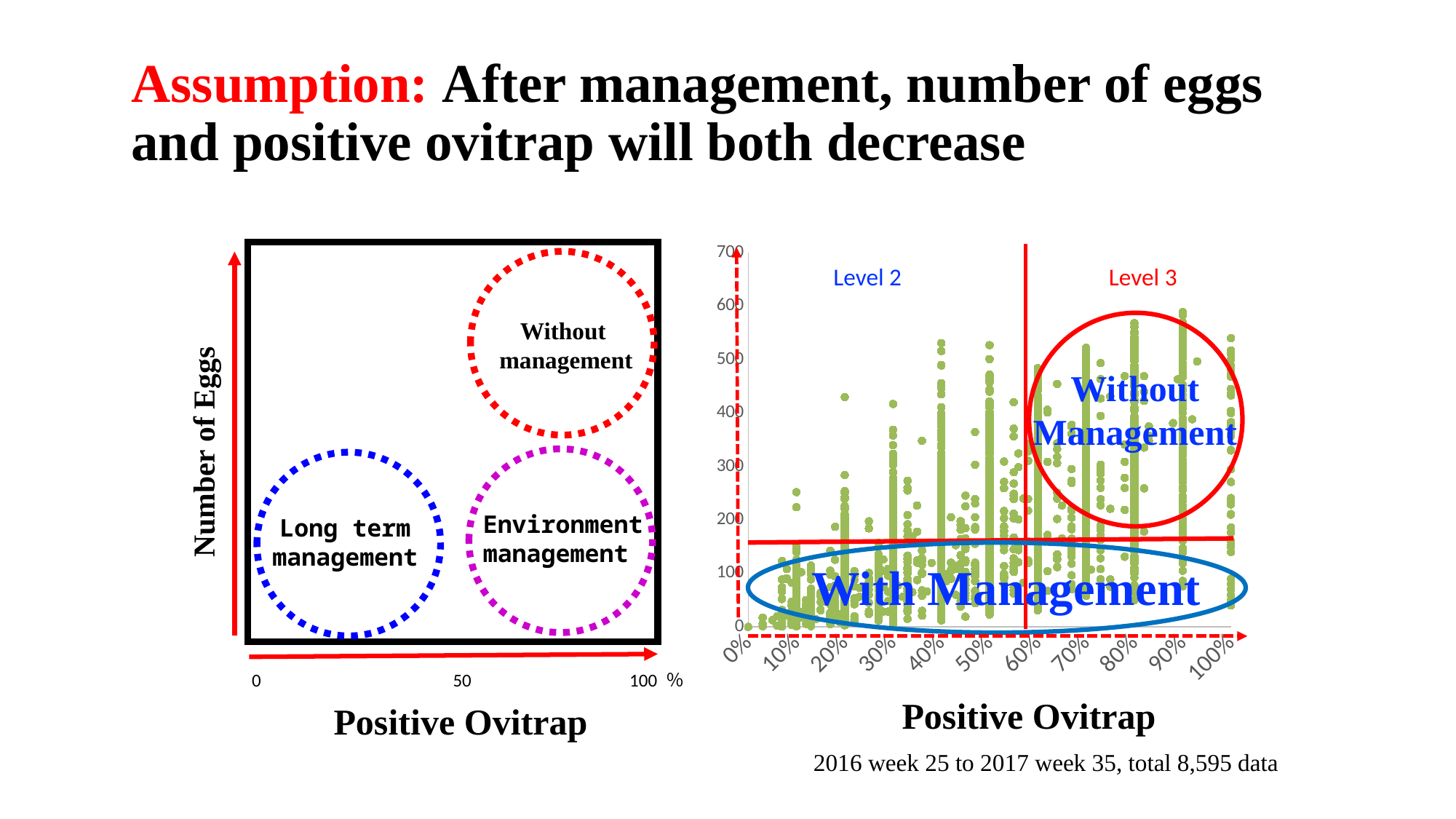
What is the x-axis label of the right chart? Positive Ovitrap According to the caption under the right chart, how many data points are plotted in total? 8,595 What kind of chart is the chart on the right of the slide? scatter plot In the right chart, at what Positive Ovitrap percentage is the vertical red line drawn? 60% In the right chart, what label is written inside the blue ellipse? With Management In the right chart, is the horizontal red line greater or less than 200 on the vertical axis? less In the right chart, is the horizontal red line greater or less than 100 on the vertical axis? greater In the right chart, which region label is placed to the right of the vertical red line, Level 2 or Level 3? Level 3 In the right chart, do the maximum egg counts generally rise or fall as Positive Ovitrap increases from 0% to 100%? rise How many dotted circles are drawn in the left diagram? 3 In the right chart, is the highest plotted point greater or less than 500 on the vertical axis? greater